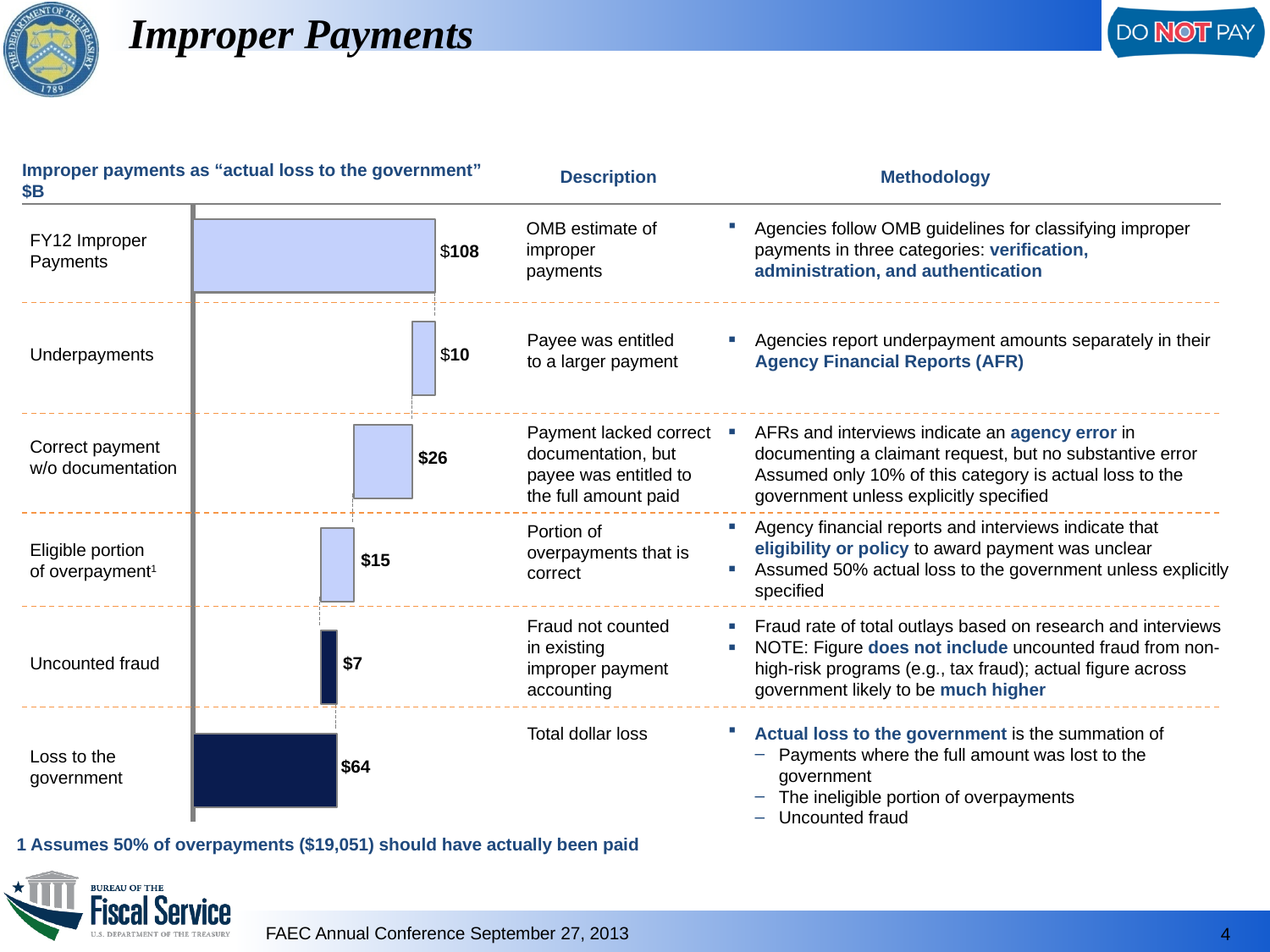
Which category has the largest value in the chart? FY12 Improper Payments Which is larger, the value for Correct payment w/o documentation or the value for Eligible portion of overpayment? Correct payment w/o documentation What is the value shown for Underpayments? $10 Which category has the smallest value in the chart? Uncounted fraud What is the value shown for Correct payment w/o documentation? $26 How many categories are shown in the chart? 6 What kind of chart is shown on the slide? Bar chart What is the value shown for Loss to the government? $64 What unit is stated under the chart title? $B What is the difference between the FY12 Improper Payments value and the Loss to the government value? $44 What is the value shown for FY12 Improper Payments? $108 What is the value shown for Uncounted fraud? $7